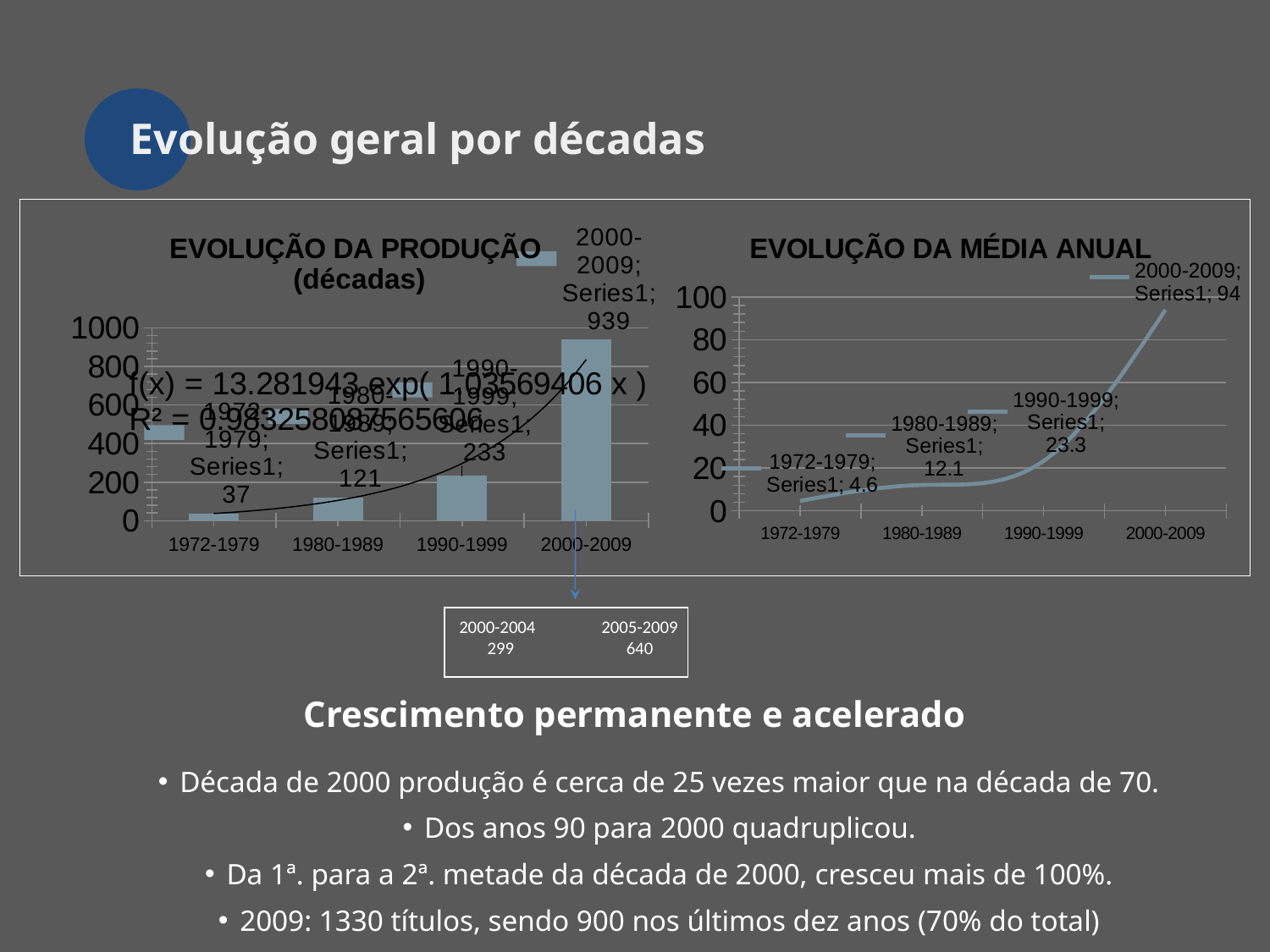
In the chart titled EVOLUÇÃO DA PRODUÇÃO (décadas), what is the value for 1980-1989? 121 In the chart titled EVOLUÇÃO DA PRODUÇÃO (décadas), how many decades are shown on the x axis? 4 In the chart titled EVOLUÇÃO DA PRODUÇÃO (décadas), what is the difference between the values for 1990-1999 and 1980-1989? 112 What kind of chart is the one titled EVOLUÇÃO DA MÉDIA ANUAL? Line chart In the chart titled EVOLUÇÃO DA MÉDIA ANUAL, what is the value for 1972-1979? 4.6 In the chart titled EVOLUÇÃO DA MÉDIA ANUAL, do the values rise or fall from 1972-1979 to 2000-2009? Rise In the chart titled EVOLUÇÃO DA MÉDIA ANUAL, what is the value for 1990-1999? 23.3 In the chart titled EVOLUÇÃO DA PRODUÇÃO (décadas), what is the value for 2000-2009? 939 In the chart titled EVOLUÇÃO DA MÉDIA ANUAL, what is the difference between the values for 2000-2009 and 1990-1999? 70.7 What kind of chart is the one titled EVOLUÇÃO DA PRODUÇÃO (décadas)? Bar chart In the chart titled EVOLUÇÃO DA MÉDIA ANUAL, which decade has the highest value? 2000-2009 In the chart titled EVOLUÇÃO DA PRODUÇÃO (décadas), which decade has the lowest value? 1972-1979